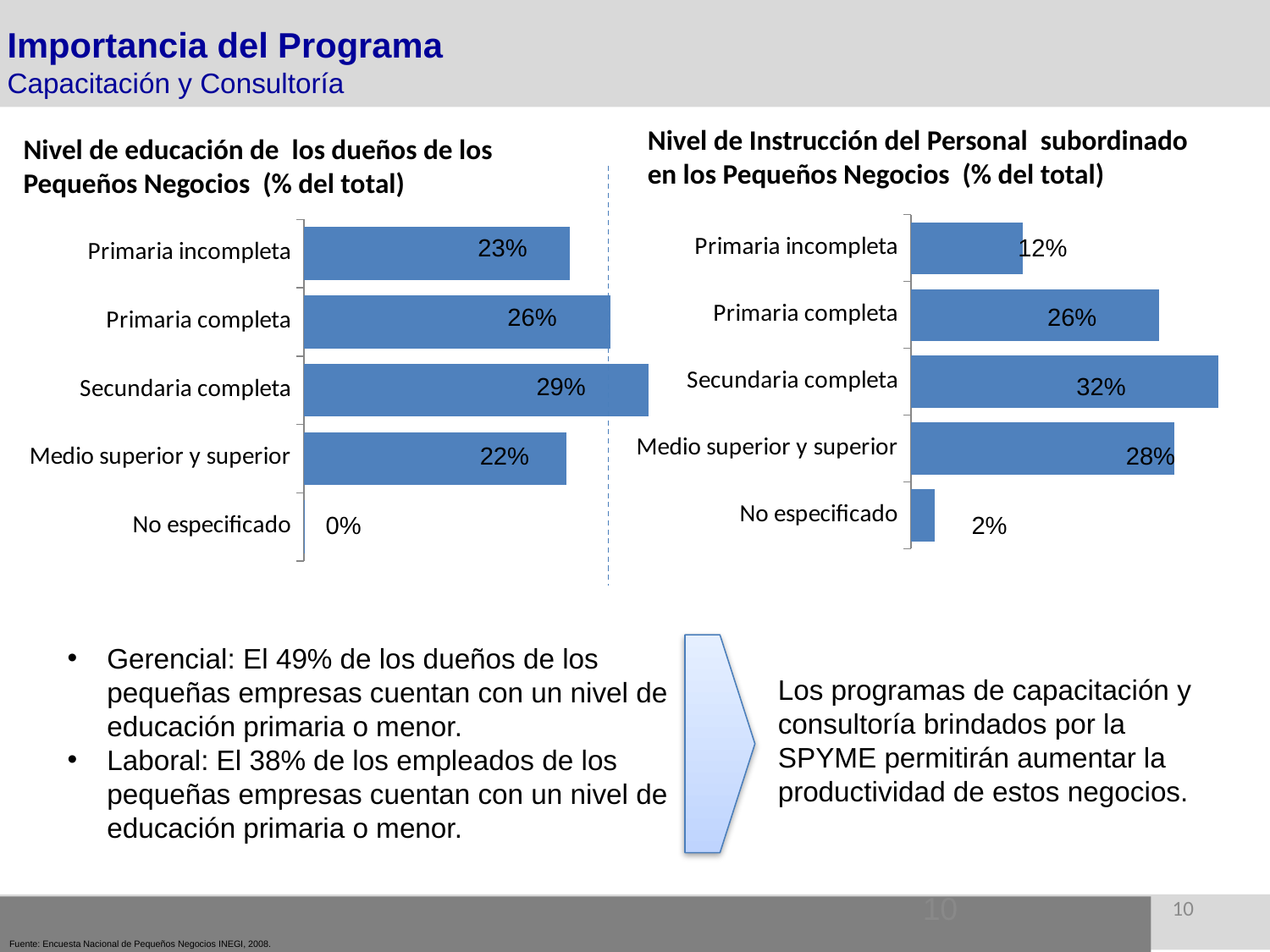
In the left chart (Nivel de educación de los dueños), which is larger: Primaria incompleta or Medio superior y superior? Primaria incompleta In the left chart (Nivel de educación de los dueños de los Pequeños Negocios), what is the value for Secundaria completa? 29% What kind of chart is the right chart (Nivel de Instrucción del Personal subordinado)? Bar chart In the right chart (Nivel de Instrucción del Personal subordinado), what is the value for Medio superior y superior? 28% In the right chart (Nivel de Instrucción del Personal subordinado), what is the value for Primaria incompleta? 12% In the right chart (Nivel de Instrucción del Personal subordinado), which is larger: Medio superior y superior or Primaria completa? Medio superior y superior In the left chart (Nivel de educación de los dueños), which category has the highest value? Secundaria completa How many categories does the left chart (Nivel de educación de los dueños) show? 5 In the left chart (Nivel de educación de los dueños), what is the difference between Primaria completa and Medio superior y superior? 4% In the right chart (Nivel de Instrucción del Personal subordinado), what is the difference between Secundaria completa and Primaria completa? 6% In the right chart (Nivel de Instrucción del Personal subordinado), which category has the lowest value? No especificado In the left chart (Nivel de educación de los dueños), what is the value for No especificado? 0%